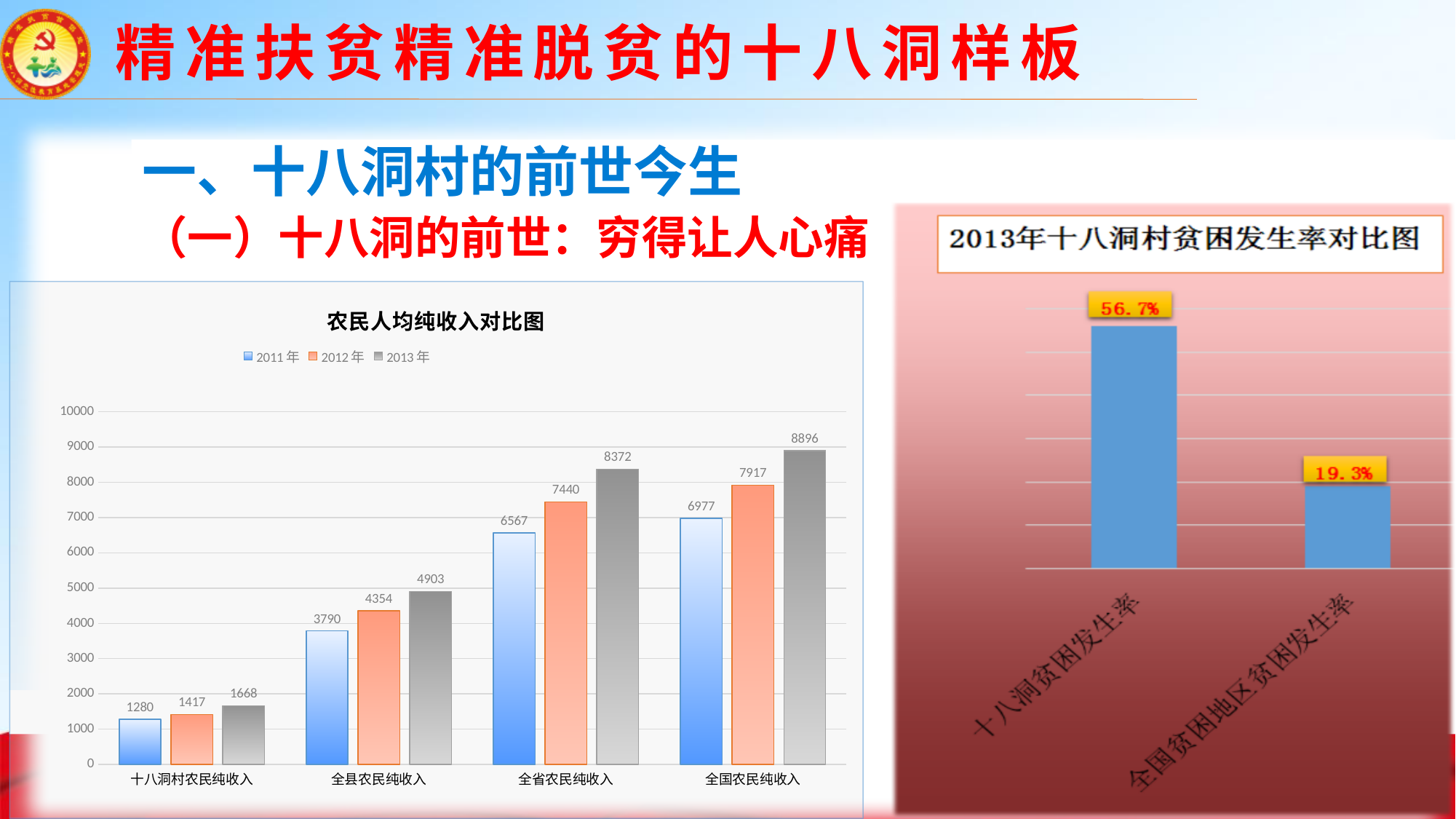
In the chart titled 农民人均纯收入对比图, what is the value for 全国农民纯收入 in 2011年? 6977 In the chart titled 农民人均纯收入对比图, do the values for 全县农民纯收入 rise or fall from 2011年 to 2013年? rise In the chart titled 农民人均纯收入对比图, which category has the highest value for 2013年? 全国农民纯收入 In the chart titled 农民人均纯收入对比图, how many categories are shown on the x axis? 4 In the chart titled 2013年十八洞村贫困发生率对比图, what is the value for 十八洞贫困发生率? 56.7% In the chart titled 2013年十八洞村贫困发生率对比图, what is the difference between 十八洞贫困发生率 and 全国贫困地区贫困发生率? 37.4% In the chart titled 农民人均纯收入对比图, which is larger: the 2012年 value for 全县农民纯收入 or the 2011年 value for 全省农民纯收入? 2011年 value for 全省农民纯收入 In the chart titled 农民人均纯收入对比图, what is the difference between the 2013年 values for 全国农民纯收入 and 十八洞村农民纯收入? 7228 In the chart titled 农民人均纯收入对比图, what is the value for 全省农民纯收入 in 2012年? 7440 In the chart titled 农民人均纯收入对比图, how many series does the legend list? 3 In the chart titled 农民人均纯收入对比图, what is the value for 十八洞村农民纯收入 in 2013年? 1668 In the chart titled 农民人均纯收入对比图, which category has the lowest value for 2011年? 十八洞村农民纯收入